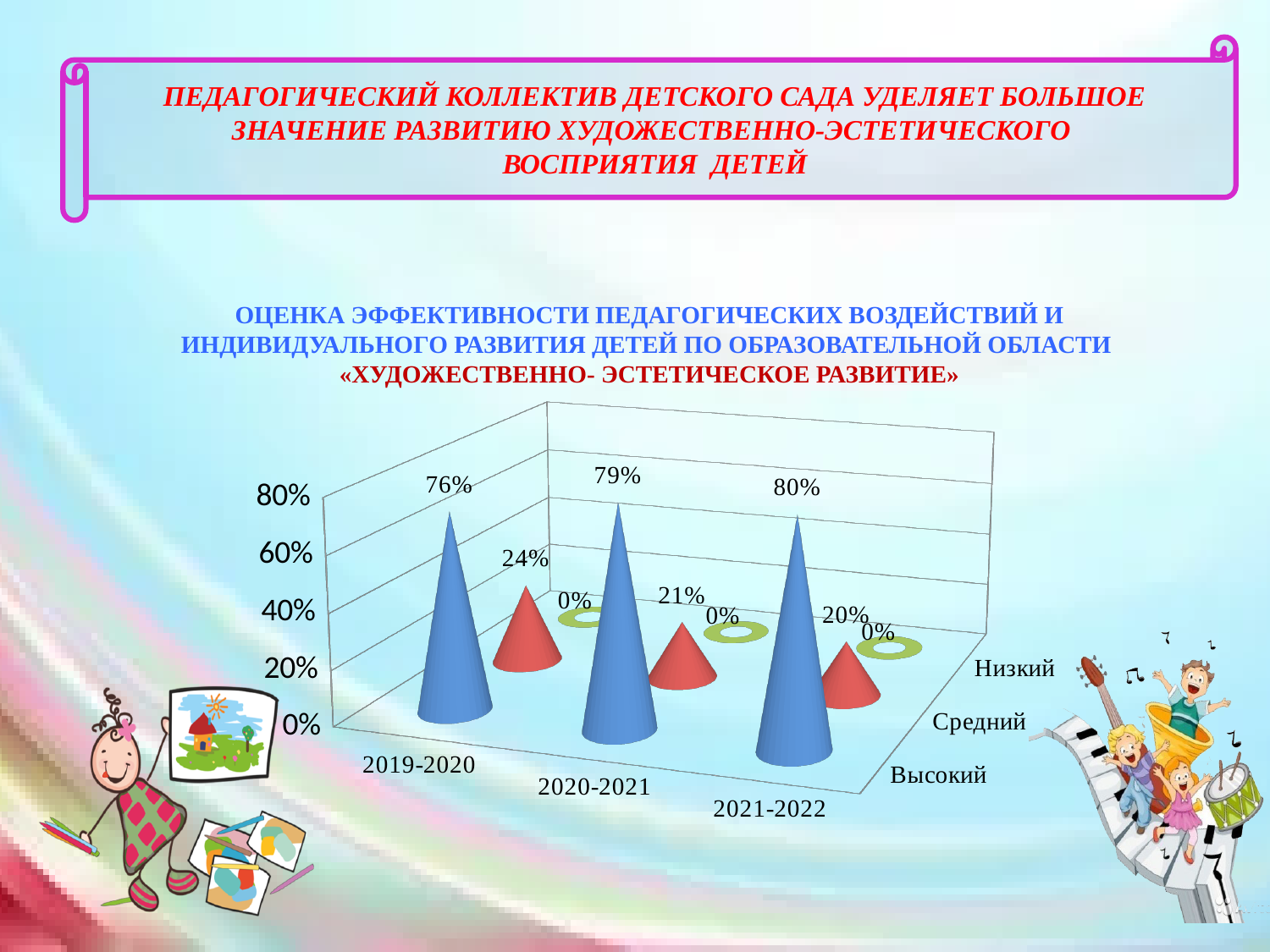
Does the Высокий value rise or fall from 2019-2020 to 2021-2022? rise What is the difference between the Высокий values for 2021-2022 and 2019-2020? 4% What is the value for Средний in 2020-2021? 21% How many years are shown on the x axis? 3 What is the total of the Высокий and Средний values for 2020-2021? 100% What is the value for Высокий in 2019-2020? 76% Which is larger: the Средний value in 2019-2020 or in 2021-2022? 2019-2020 In which year is the Высокий value the highest? 2021-2022 How many series does the chart show? 3 In which year is the Средний value the lowest? 2021-2022 What is the value for Низкий in 2021-2022? 0% What is the value for Высокий in 2021-2022? 80%